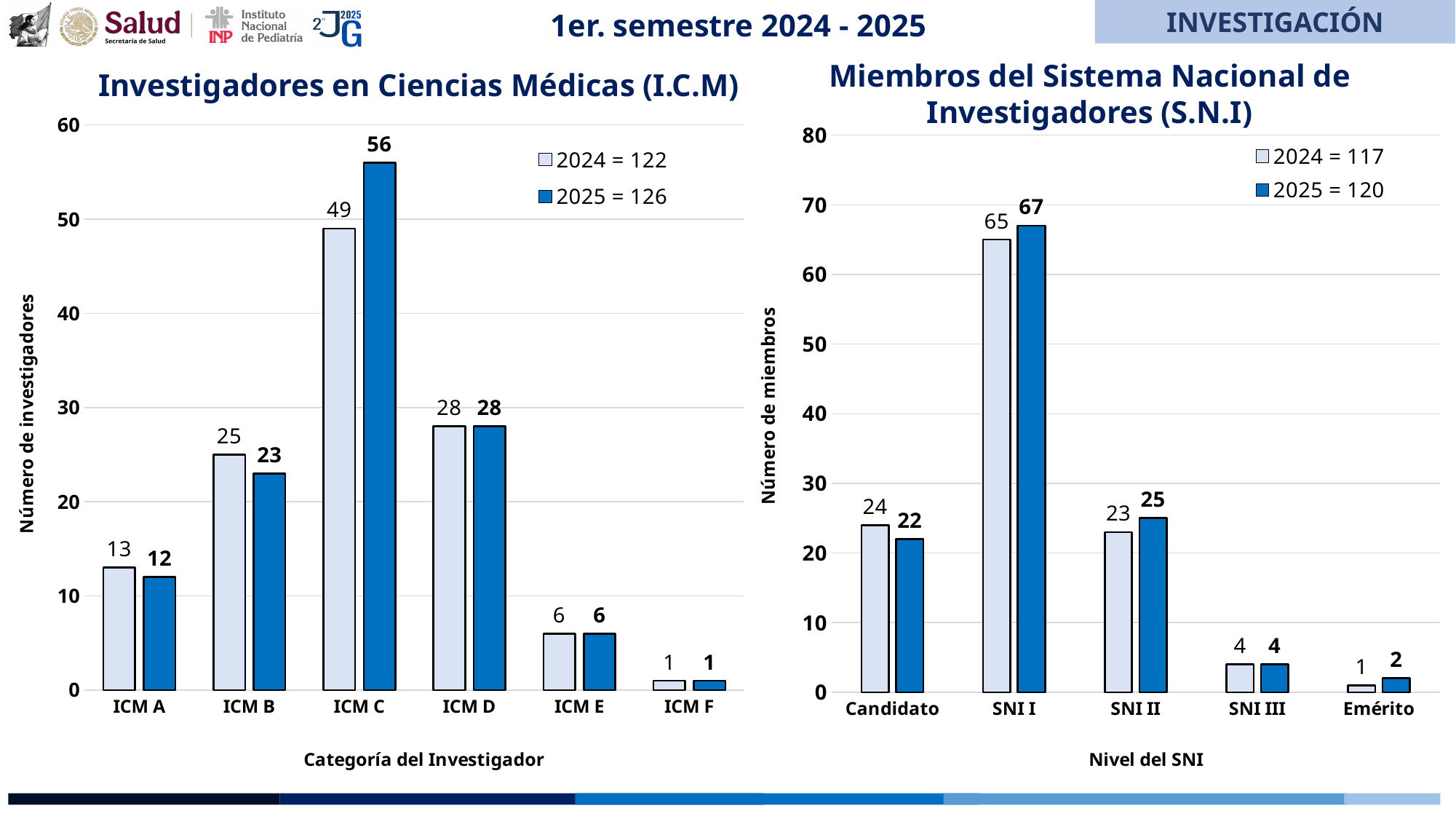
In the 'Miembros del Sistema Nacional de Investigadores (S.N.I)' chart, how many series does the legend list? 2 In the 'Investigadores en Ciencias Médicas (I.C.M)' chart, what is the difference between the 2025 and 2024 values for ICM C? 7 In the 'Investigadores en Ciencias Médicas (I.C.M)' chart, which category has the highest 2024 value? ICM C In the 'Miembros del Sistema Nacional de Investigadores (S.N.I)' chart, what is the 2024 value for Candidato? 24 In the 'Miembros del Sistema Nacional de Investigadores (S.N.I)' chart, what is the 2025 value for SNI I? 67 In the 'Miembros del Sistema Nacional de Investigadores (S.N.I)' chart, which is larger for SNI II: the 2024 value or the 2025 value? 2025 What kind of chart is the 'Miembros del Sistema Nacional de Investigadores (S.N.I)' chart? Bar chart In the 'Investigadores en Ciencias Médicas (I.C.M)' chart, how many categories are shown on the x axis? 6 In the 'Investigadores en Ciencias Médicas (I.C.M)' chart, what is the 2024 value for ICM B? 25 In the 'Investigadores en Ciencias Médicas (I.C.M)' chart, what is the 2025 value for ICM C? 56 In the 'Investigadores en Ciencias Médicas (I.C.M)' chart, which category has the lowest 2025 value? ICM F In the 'Miembros del Sistema Nacional de Investigadores (S.N.I)' chart, what is the difference between the 2024 values for SNI I and Candidato? 41